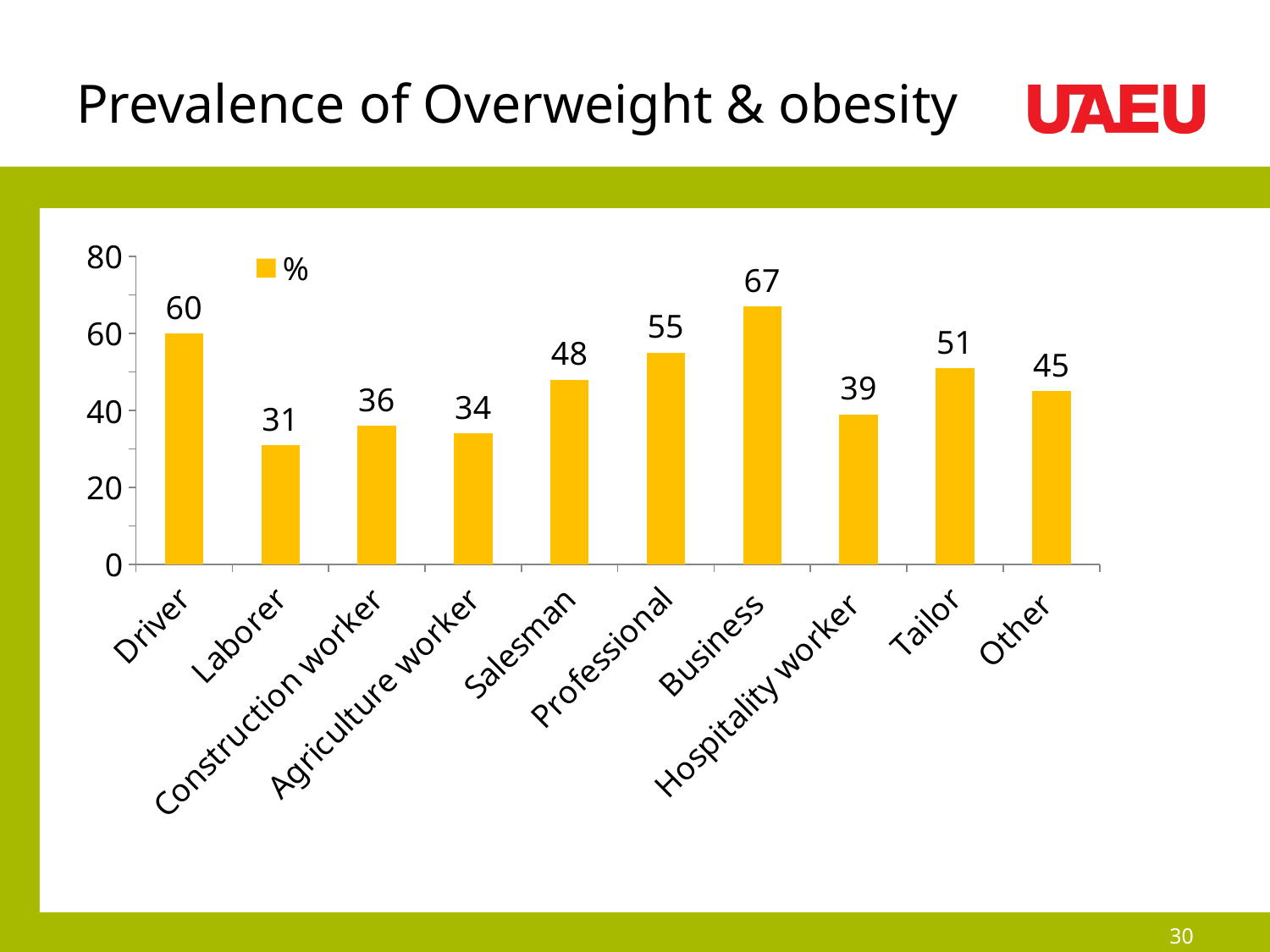
What is the legend entry for the series shown? % What is the value for Driver? 60 Which category has the lowest value? Laborer How many categories are shown on the x axis? 10 What is the difference between the values for Professional and Salesman? 7 What is the value for Agriculture worker? 34 What is the difference between the values for Business and Laborer? 36 What kind of chart is shown on the slide? bar chart Is the value for Construction worker greater or less than 40? less Which is larger, the value for Tailor or the value for Other? Tailor Which category has the highest value? Business What is the value for Hospitality worker? 39